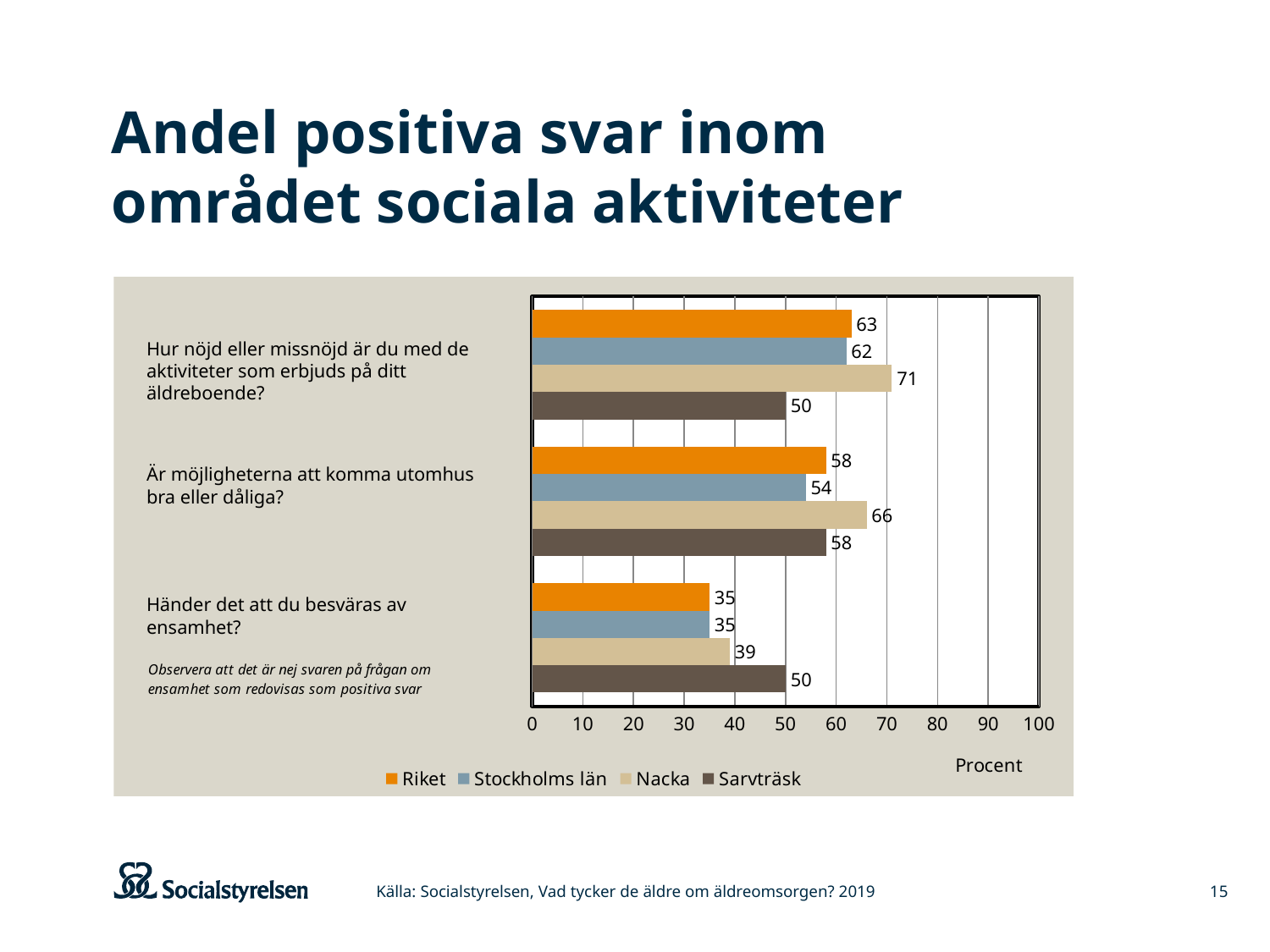
What is the label on the horizontal axis of the chart? Procent Is the value for Riket on the question "Händer det att du besväras av ensamhet?" greater or less than 40? less What kind of chart is shown on the slide? Bar chart How many series does the legend list? 4 What value is shown for Nacka on the question "Hur nöjd eller missnöjd är du med de aktiviteter som erbjuds på ditt äldreboende?"? 71 Which series has the highest value on the question "Är möjligheterna att komma utomhus bra eller dåliga?"? Nacka Which is larger on the question "Händer det att du besväras av ensamhet?": the value for Nacka or the value for Sarvträsk? Sarvträsk Which series has the lowest value on the question "Hur nöjd eller missnöjd är du med de aktiviteter som erbjuds på ditt äldreboende?"? Sarvträsk What is the difference between the Nacka and Sarvträsk values on the question "Hur nöjd eller missnöjd är du med de aktiviteter som erbjuds på ditt äldreboende?"? 21 What value is shown for Sarvträsk on the question "Händer det att du besväras av ensamhet?"? 50 How many questions (categories) are shown on the chart? 3 What value is shown for Stockholms län on the question "Är möjligheterna att komma utomhus bra eller dåliga?"? 54